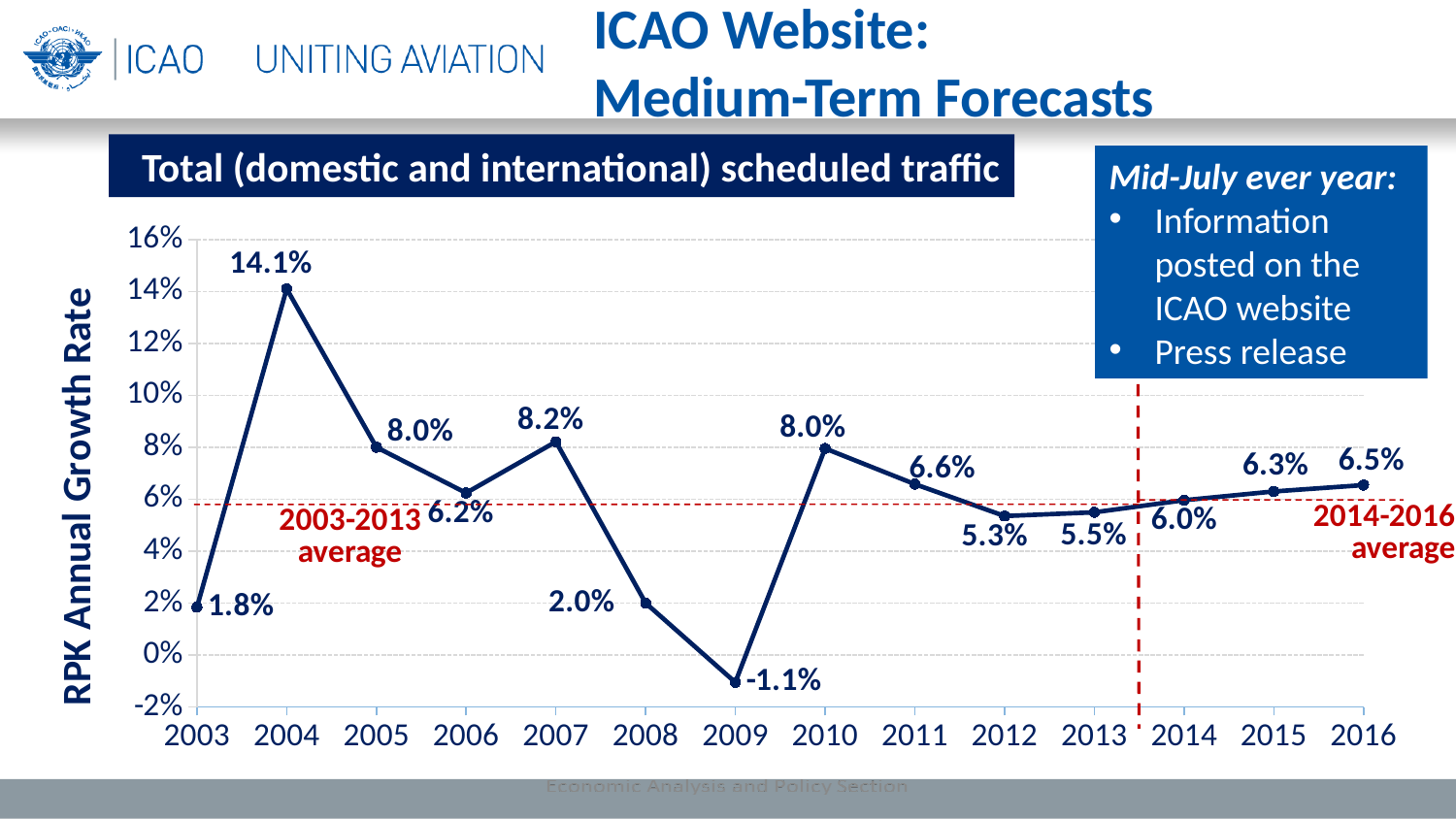
Do the growth rates rise or fall from 2013 to 2016? Rise Which year has the higher growth rate, 2007 or 2011? 2007 What is the RPK annual growth rate for 2016? 6.5% What is the RPK annual growth rate for 2012? 5.3% How many years are plotted on the chart? 14 What is the RPK annual growth rate for 2009? -1.1% What is the label on the vertical axis of the chart? RPK Annual Growth Rate What is the difference between the growth rates for 2004 and 2005? 6.1% What is the RPK annual growth rate for 2004? 14.1% What type of chart is shown on the slide? Line chart Which year has the lowest RPK annual growth rate? 2009 Which year has the highest RPK annual growth rate? 2004